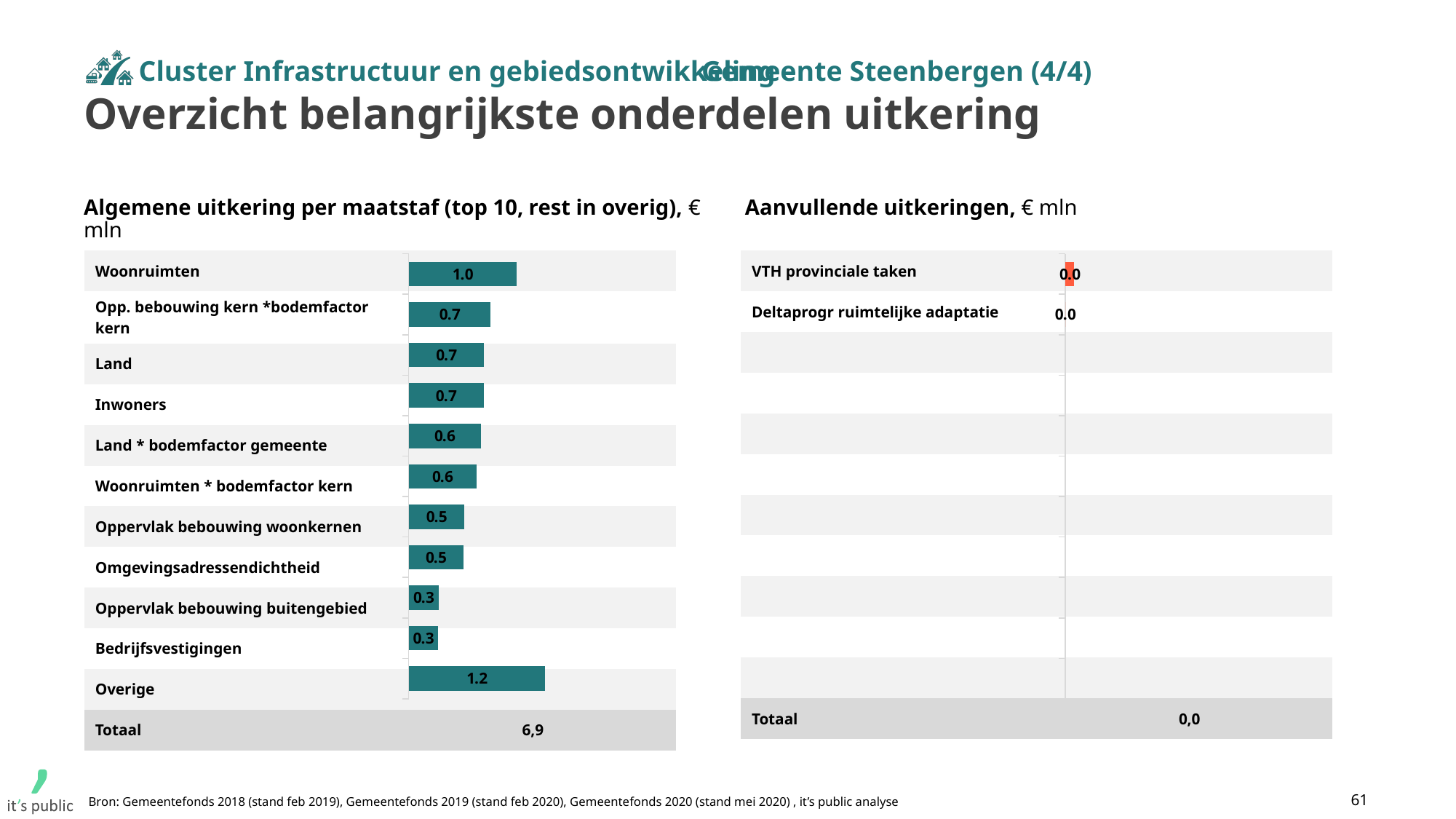
In the chart 'Aanvullende uitkeringen', what is the value for VTH provinciale taken? 0.0 In the chart 'Algemene uitkering per maatstaf', what is the value for Bedrijfsvestigingen? 0.3 In the chart 'Algemene uitkering per maatstaf', what is the difference between the values for Woonruimten and Bedrijfsvestigingen? 0.7 In the chart 'Aanvullende uitkeringen', how many categories are listed? 2 In the chart 'Algemene uitkering per maatstaf', which category has the highest value? Overige In the chart 'Algemene uitkering per maatstaf', what is the value for Woonruimten? 1.0 In the chart 'Aanvullende uitkeringen', what is the Totaal shown at the bottom? 0,0 What kind of chart is 'Algemene uitkering per maatstaf'? Bar chart In the chart 'Algemene uitkering per maatstaf', which is larger: the value for Woonruimten or the value for Land? Woonruimten In the chart 'Algemene uitkering per maatstaf', what is the Totaal shown at the bottom? 6,9 In the chart 'Algemene uitkering per maatstaf', how many categories (bars) are shown, including Overige? 11 In the chart 'Algemene uitkering per maatstaf', what is the value for Omgevingsadressendichtheid? 0.5